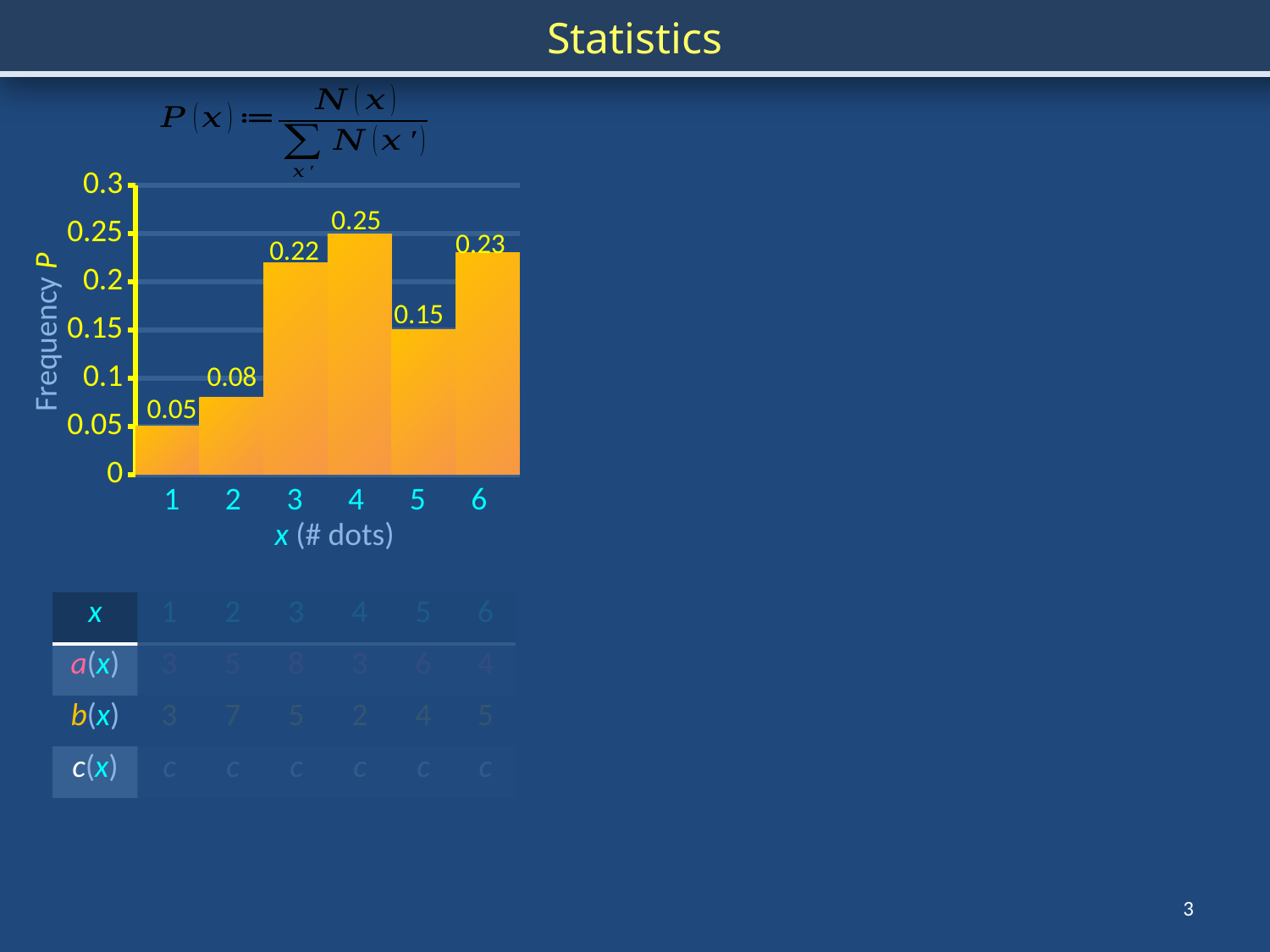
What is the label of the x axis of the chart? x (# dots) What is the frequency P for x = 5? 0.15 What kind of chart is shown on the slide? bar chart Which has a larger frequency P, x = 3 or x = 6? x = 6 What is the frequency P for x = 1? 0.05 Is the frequency for x = 6 greater or less than 0.2? greater What is the difference between the frequency for x = 2 and the frequency for x = 1? 0.03 How many x categories are shown on the chart? 6 What is the frequency P for x = 3? 0.22 Which value of x has the lowest frequency P? 1 What is the difference between the frequency for x = 4 and the frequency for x = 5? 0.1 Which value of x has the highest frequency P? 4